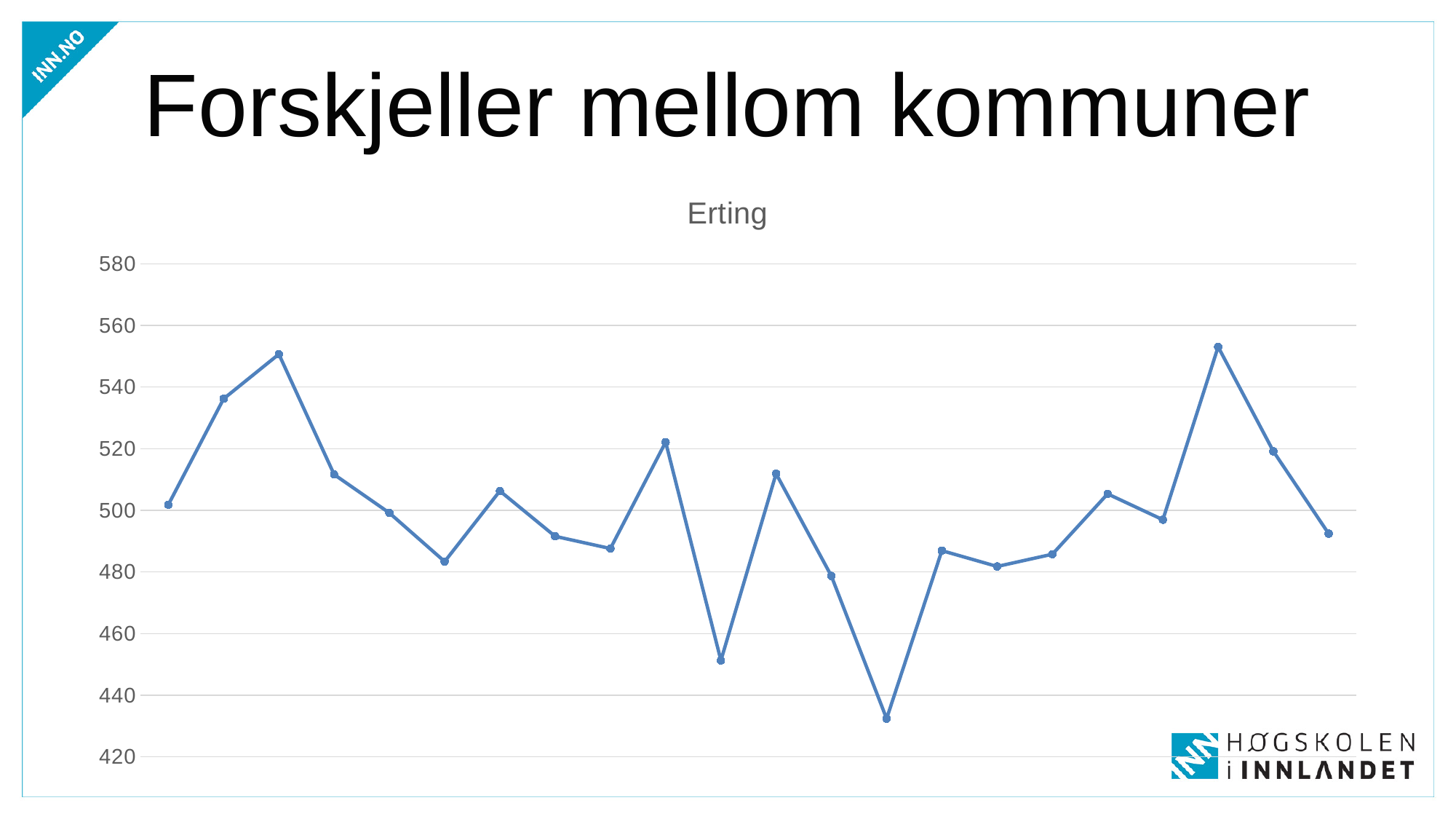
Which is larger, the value of the third point or the value of the last point? the third point Is the value of the second point on the line greater or less than 520? greater Is the highest point on the line greater or less than 540? greater Is the value of the last point on the line greater or less than 500? less Does the line rise or fall between the first and second points? rise What kind of chart is shown on the slide? line chart How many data points are plotted on the line? 22 What is the lowest value shown on the vertical axis? 420 What is the title of the chart? Erting